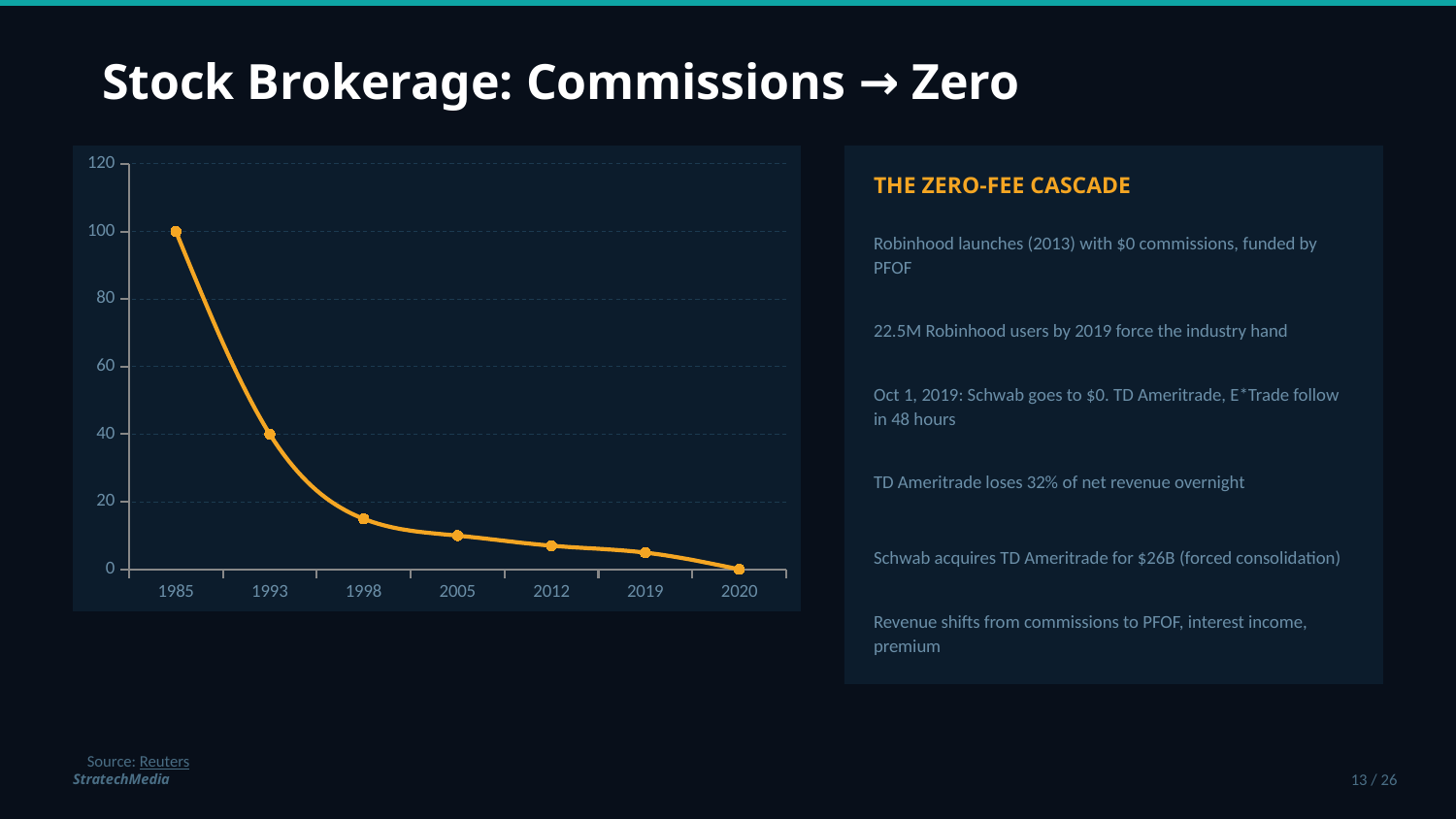
How many data points are plotted on the line? 7 Which year has the highest value on the chart? 1985 What is the value plotted for 1993? 40 What is the value plotted for 2020? 0 Is the value for 2005 greater or less than 20? less Do the values rise or fall from 1985 to 2020? fall Is the value for 1998 greater or less than 20? less What kind of chart is shown on the slide? line chart Which year has the lowest value on the chart? 2020 Which is larger, the value for 1985 or the value for 1993? 1985 What is the value plotted for 1985? 100 What is the difference between the value for 1985 and the value for 1993? 60